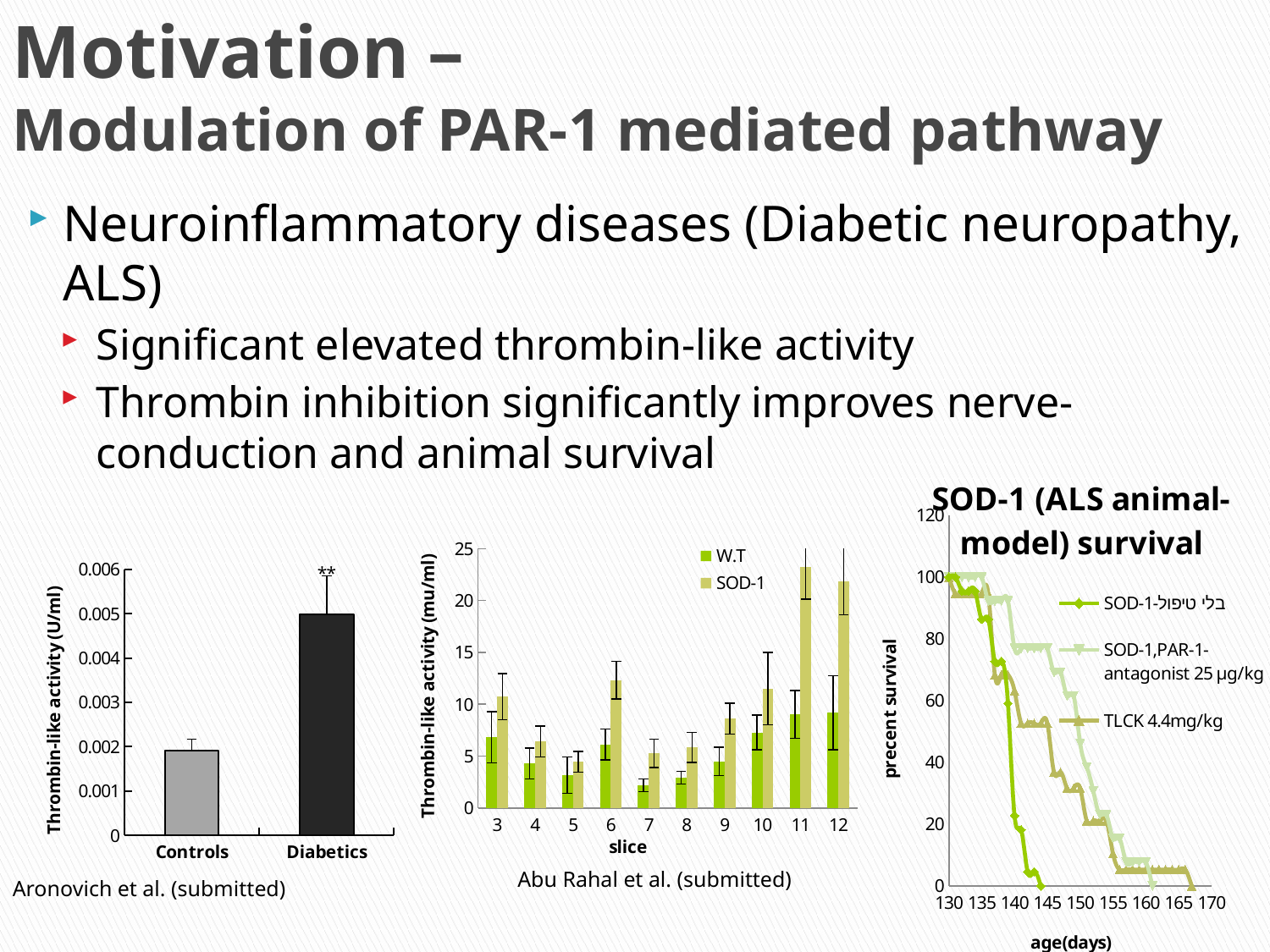
In the right chart (SOD-1 (ALS animal-model) survival), do the survival values rise or fall as age increases? fall In the middle chart (Thrombin-like activity by slice), at which slice is the SOD-1 value highest? 11 In the middle chart (Thrombin-like activity by slice), which series is larger at slice 6, W.T or SOD-1? SOD-1 In the left chart (Controls vs Diabetics), is the value for Controls greater or less than 0.003? less In the left chart (Controls vs Diabetics), is the value for Diabetics greater or less than 0.004? greater In the middle chart (Thrombin-like activity by slice), how many series does the legend list? 2 In the middle chart (Thrombin-like activity by slice), is the SOD-1 value at slice 11 greater or less than 20? greater In the left chart (Controls vs Diabetics), how many categories are shown on the x axis? 2 In the right chart (SOD-1 (ALS animal-model) survival), how many series does the legend list? 3 In the middle chart (Thrombin-like activity by slice), how many slices are shown on the x axis? 10 In the left chart (Thrombin-like activity, Controls vs Diabetics), what kind of chart is it? bar chart In the left chart (Controls vs Diabetics), which category has the higher thrombin-like activity? Diabetics